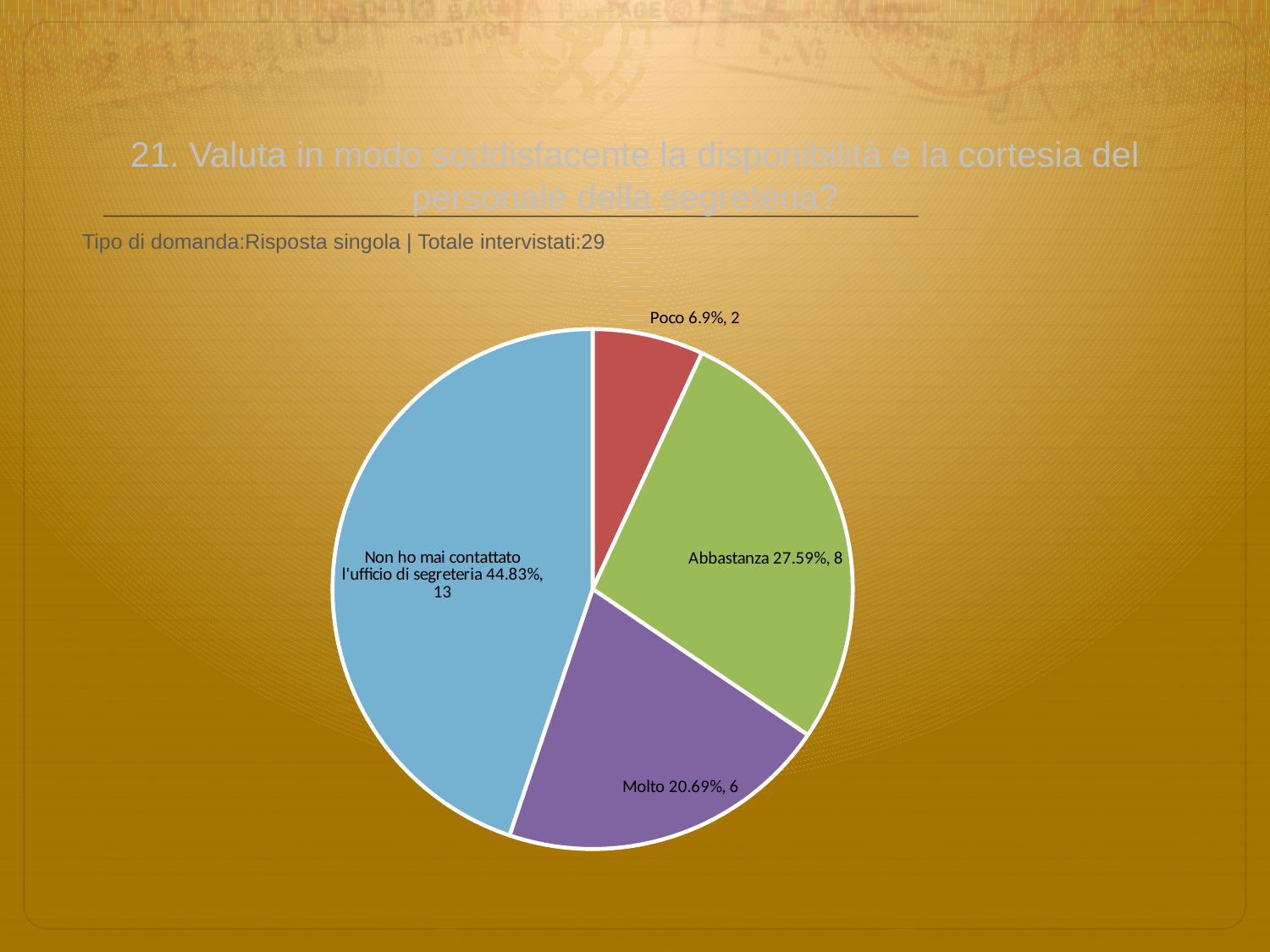
Which category has the smallest slice of the pie? Poco What is the total number of respondents across all slices? 29 What colour is the 'Abbastanza' slice? green What kind of chart is shown on the slide? pie chart What percentage share does the 'Poco' slice have? 6.9% What is the difference in respondent count between 'Abbastanza' and 'Molto'? 2 Which has more respondents, 'Molto' or 'Poco'? Molto What percentage share does the 'Molto' slice have? 20.69% How many respondents chose 'Non ho mai contattato l'ufficio di segreteria'? 13 Which category has the largest slice of the pie? Non ho mai contattato l'ufficio di segreteria How many respondents chose 'Abbastanza'? 8 How many slices does the pie chart have? 4